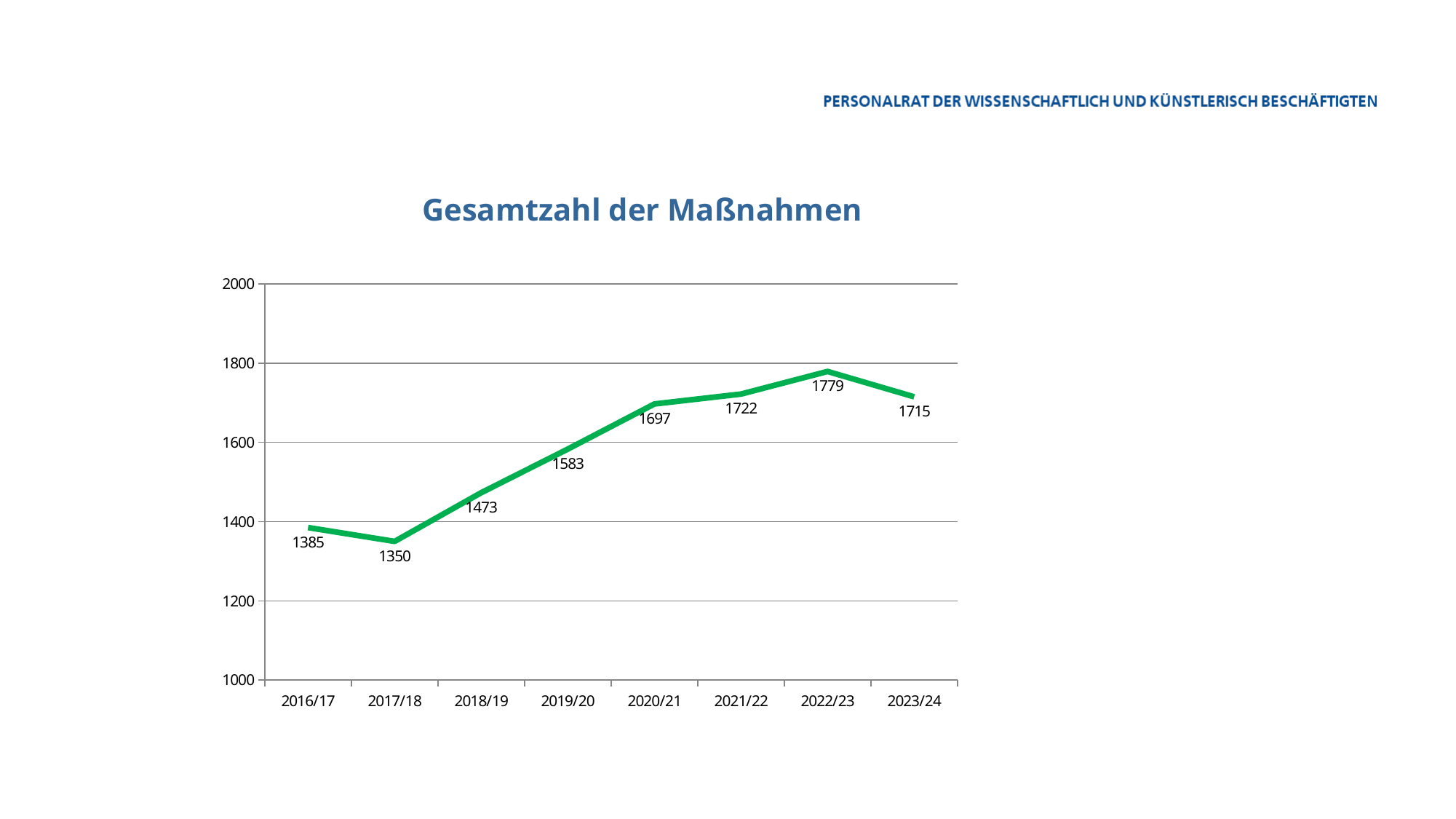
Which is larger, the value for 2018/19 or the value for 2019/20? 2019/20 What kind of chart is this? line chart What is the value for 2020/21? 1697 What is the difference between the values for 2022/23 and 2023/24? 64 What is the difference between the values for 2016/17 and 2017/18? 35 What is the title of the chart? Gesamtzahl der Maßnahmen How many years are shown on the x axis? 8 What is the value for 2016/17? 1385 Which year has the highest value? 2022/23 What is the value for 2023/24? 1715 Is the value for 2021/22 greater or less than 1600? greater Which year has the lowest value? 2017/18